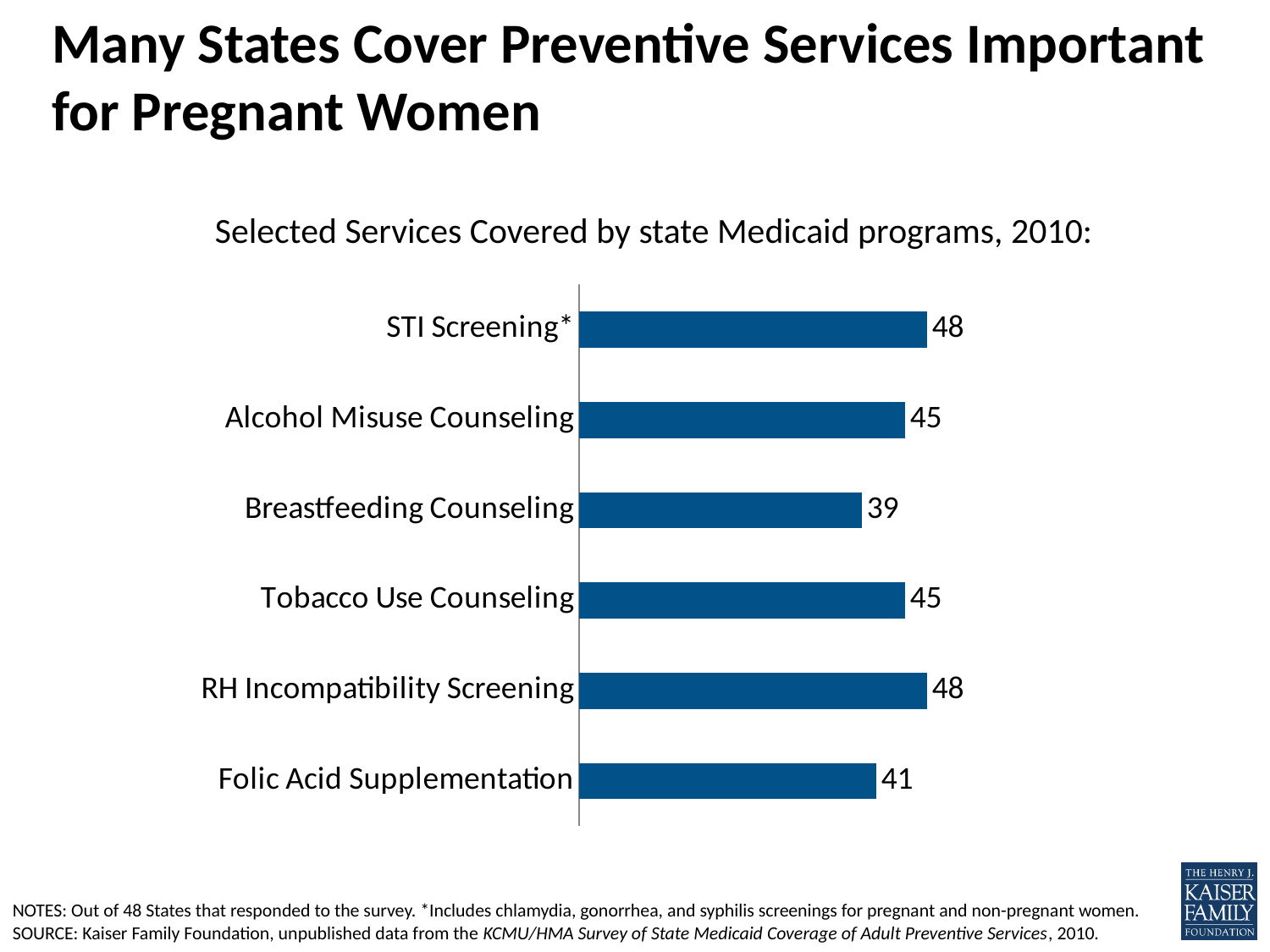
What is the difference between the values for STI Screening and Breastfeeding Counseling? 9 What is the value for Tobacco Use Counseling? 45 What is the difference between the values for Alcohol Misuse Counseling and Folic Acid Supplementation? 4 What is the subtitle shown above the chart? Selected Services Covered by state Medicaid programs, 2010: Which service has the lowest value? Breastfeeding Counseling What is the value for Folic Acid Supplementation? 41 Which is larger, the value for Tobacco Use Counseling or the value for Folic Acid Supplementation? Tobacco Use Counseling Which is larger, the value for RH Incompatibility Screening or the value for Breastfeeding Counseling? RH Incompatibility Screening How many states cover STI Screening? 48 What is the value for Breastfeeding Counseling? 39 What kind of chart is shown on the slide? Bar chart How many services are shown in the chart? 6